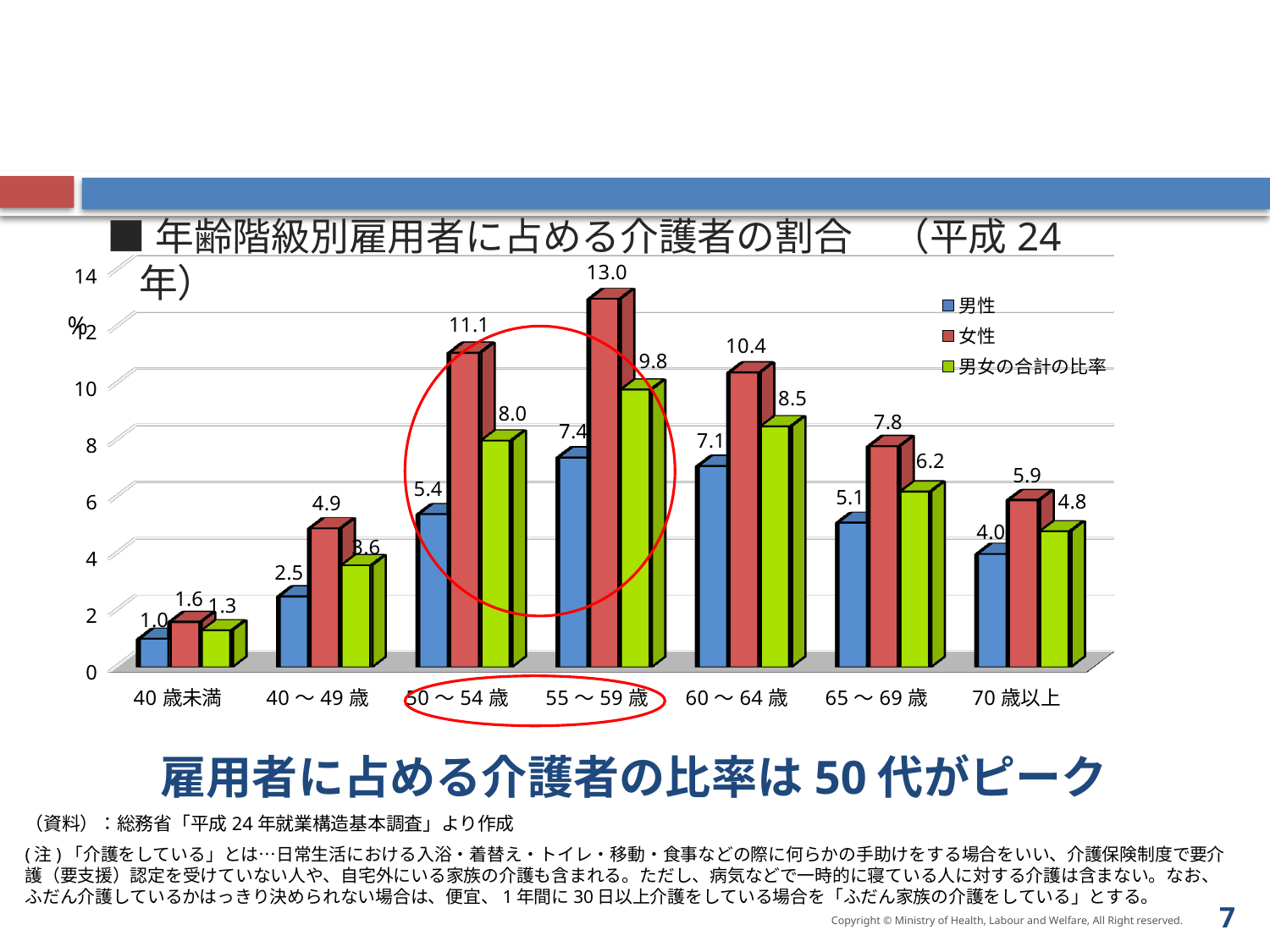
How many series does the legend list? 3 Which series is shown in green in the legend? 男女の合計の比率 What is the value for 男性 in the 50～54歳 age group? 5.4 Which is larger, the 男性 value for 55～59歳 or the 男性 value for 60～64歳? 55～59歳 What is the value for 男女の合計の比率 in the 60～64歳 age group? 8.5 What is the value for 女性 in the 55～59歳 age group? 13.0 What is the difference between the 女性 and 男性 values in the 50～54歳 age group? 5.7 Do the 女性 values rise or fall from 55～59歳 to 70歳以上? Fall Which age group has the lowest value for 男性? 40歳未満 How many age groups are shown on the x axis? 7 Which age group has the highest value for 女性? 55～59歳 What kind of chart is shown on the slide? Bar chart